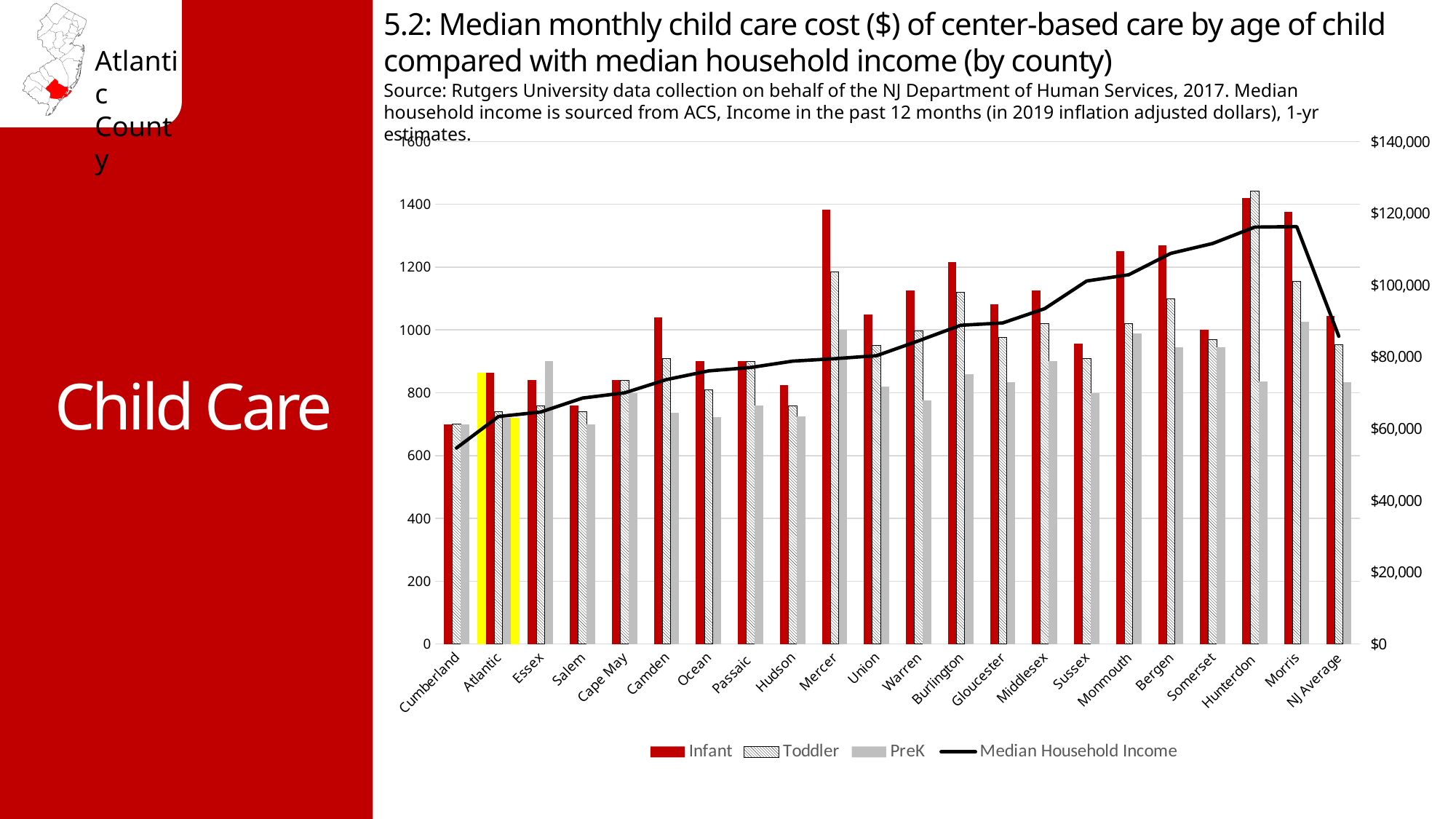
Is the Median Household Income for Morris greater or less than $100,000? greater Which category has the lowest Infant bar? Cumberland Is the Infant value for Mercer greater or less than 1200? greater What kind of chart is shown on the slide? bar chart with a line series Which is larger, the Infant value for Mercer or the Infant value for Camden? Mercer Is the Infant value for Cumberland greater or less than 800? less Which county's bars are highlighted in yellow on the chart? Atlantic Which category has the highest Infant bar? Hunterdon How many series does the chart legend list? 4 Which category has the highest Toddler bar? Hunterdon How many categories are shown along the x axis of the chart? 22 Does the Median Household Income line generally rise or fall from Cumberland to Morris? rise